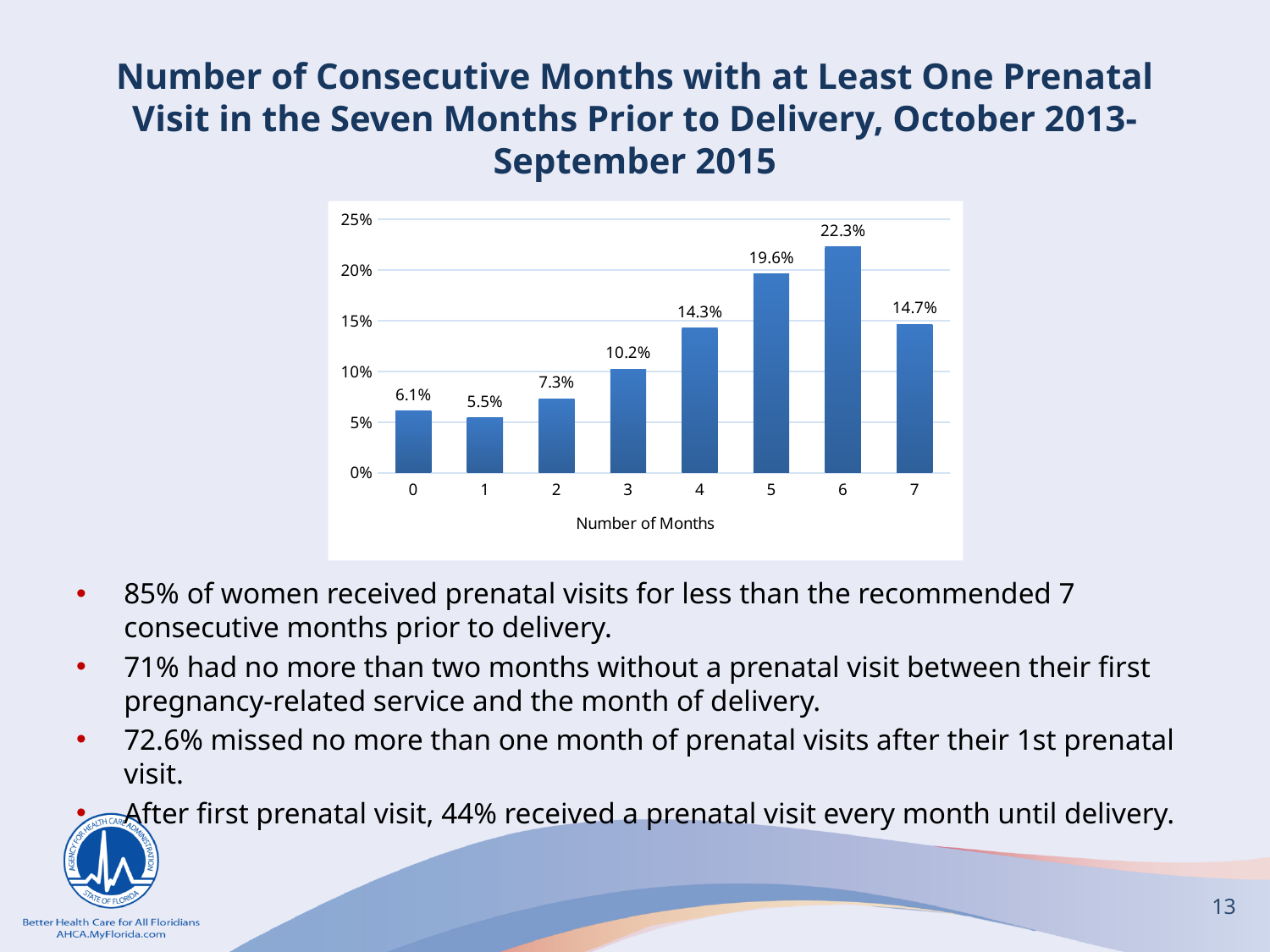
What percentage is shown for 0 consecutive months? 6.1% Which is larger, the percentage for 2 months or for 7 months? 7 months What percentage is shown for 3 consecutive months? 10.2% Which number of months has the lowest percentage? 1 Is the value for 5 months greater or less than 15%? greater How many categories (numbers of months) are shown on the x axis? 8 What percentage is shown for 6 consecutive months? 22.3% What is the x-axis title of the chart? Number of Months What is the difference between the percentages for 6 months and 7 months? 7.6% Which number of months has the highest percentage? 6 What kind of chart is shown on the slide? Bar chart What is the difference between the percentages for 5 months and 4 months? 5.3%